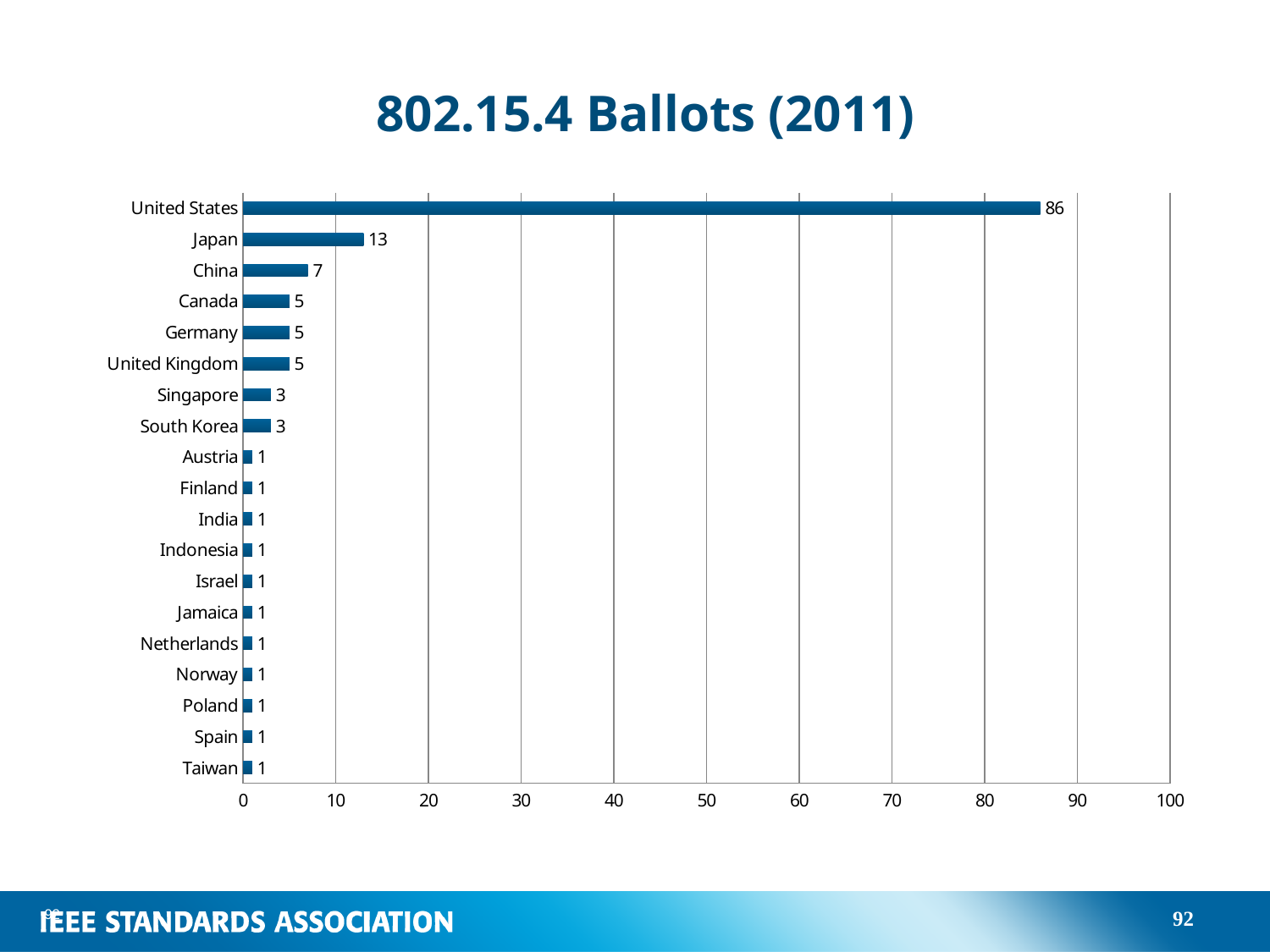
What is the title of the chart? 802.15.4 Ballots (2011) Which country has the highest number of ballots? United States What is the difference between the values for Japan and China? 6 What is the value for China? 7 What is the value for Singapore? 3 What is the value for Japan? 13 Which is larger, the value for Canada or the value for South Korea? Canada How many countries are shown on the chart? 19 What is the value for United States? 86 Is the value for United States greater or less than 80? greater What is the difference between the values for United States and Japan? 73 What kind of chart is shown on the slide? bar chart